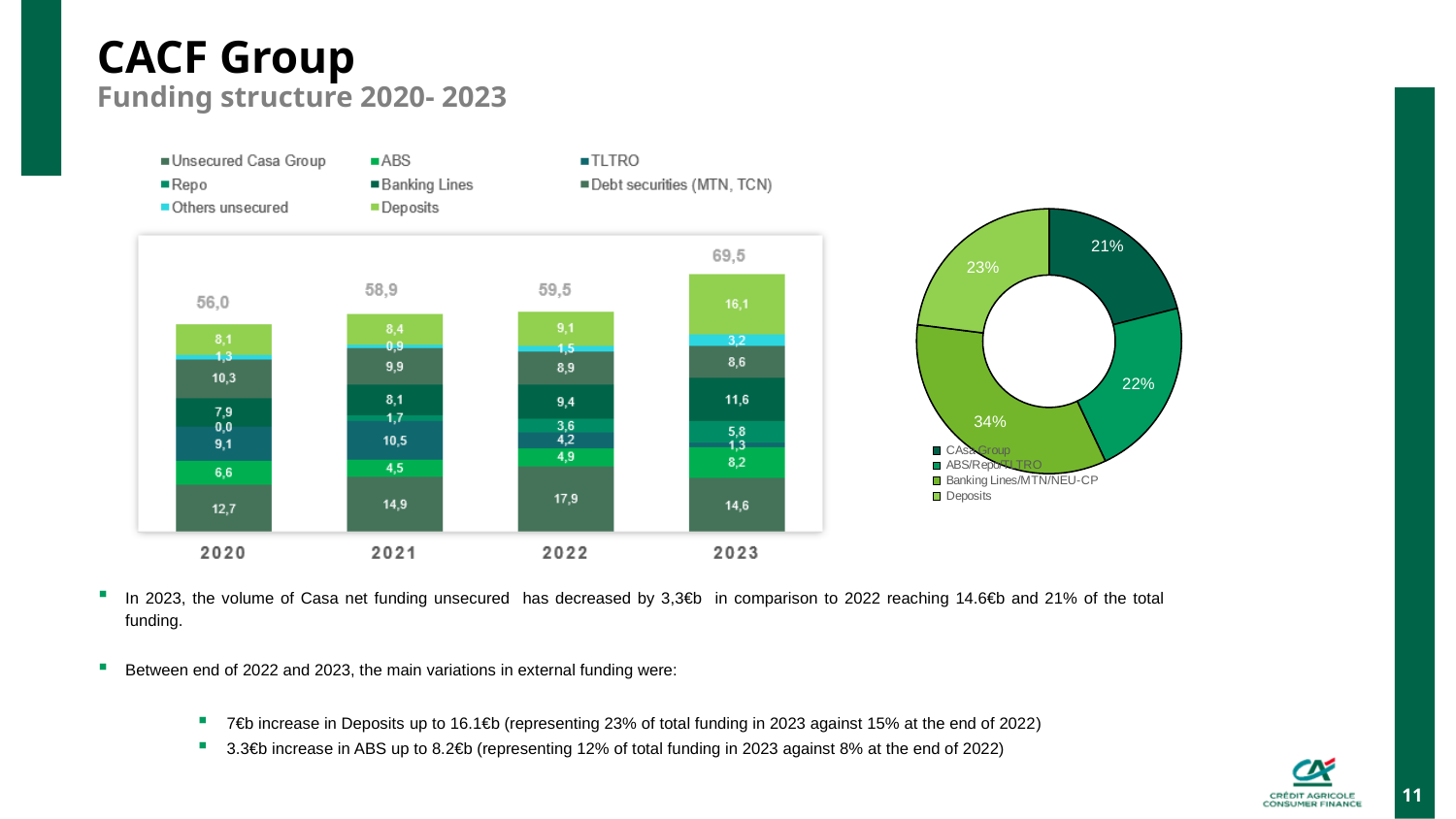
In the stacked bar chart, which year has the lowest total funding? 2020 In the donut chart on the right, what share is shown for Banking Lines/MTN/NEU-CP? 34% In the stacked bar chart, what is the total funding shown for 2020? 56,0 In the stacked bar chart, what is the total funding shown for 2023? 69,5 How many years are shown on the x axis of the stacked bar chart? 4 In the stacked bar chart, do the total funding values rise or fall from 2020 to 2023? rise How many series does the legend of the stacked bar chart list? 8 In the stacked bar chart, what is the difference between the total funding in 2023 and in 2022? 10,0 In the donut chart on the right, which category has the smallest share? CAsa Group In the stacked bar chart, which year has the highest total funding? 2023 In the stacked bar chart, is the total funding for 2021 larger or smaller than for 2022? smaller What kind of chart is the chart on the left of the slide? stacked bar chart